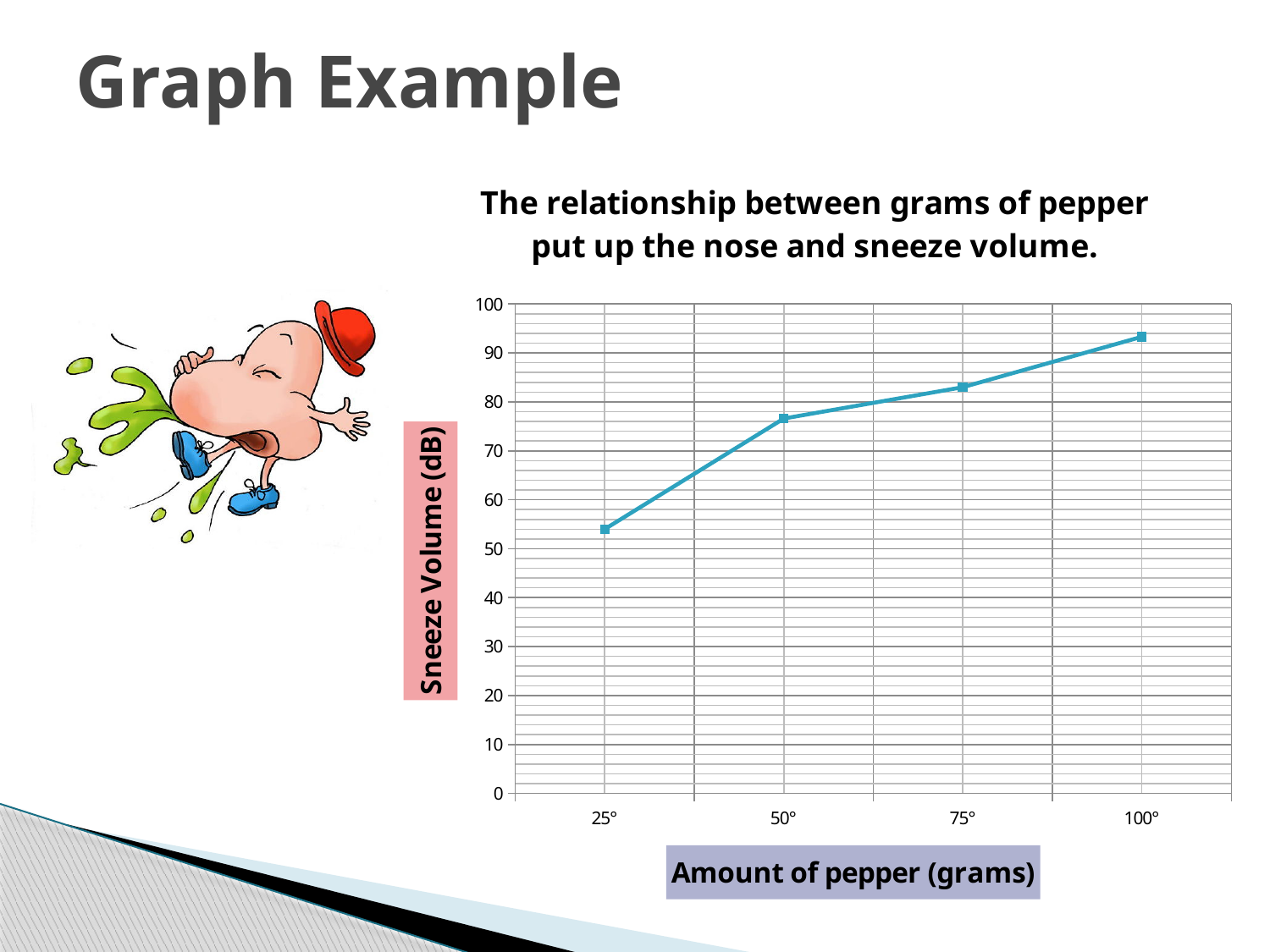
Which amount of pepper has the highest sneeze volume? 100° What is the label on the x axis of the chart? Amount of pepper (grams) Which amount of pepper has the lowest sneeze volume? 25° Is the sneeze volume for 100° greater or less than 90? greater Is the sneeze volume for 50° greater or less than 70? greater What is the label on the y axis of the chart? Sneeze Volume (dB) Is the sneeze volume for 25° greater or less than 50? greater Which has a larger sneeze volume, 25° or 50°? 50° Do the sneeze volume values rise or fall as the amount of pepper increases along the x axis? rise What kind of chart is shown on the slide? line chart How many data points are plotted on the line? 4